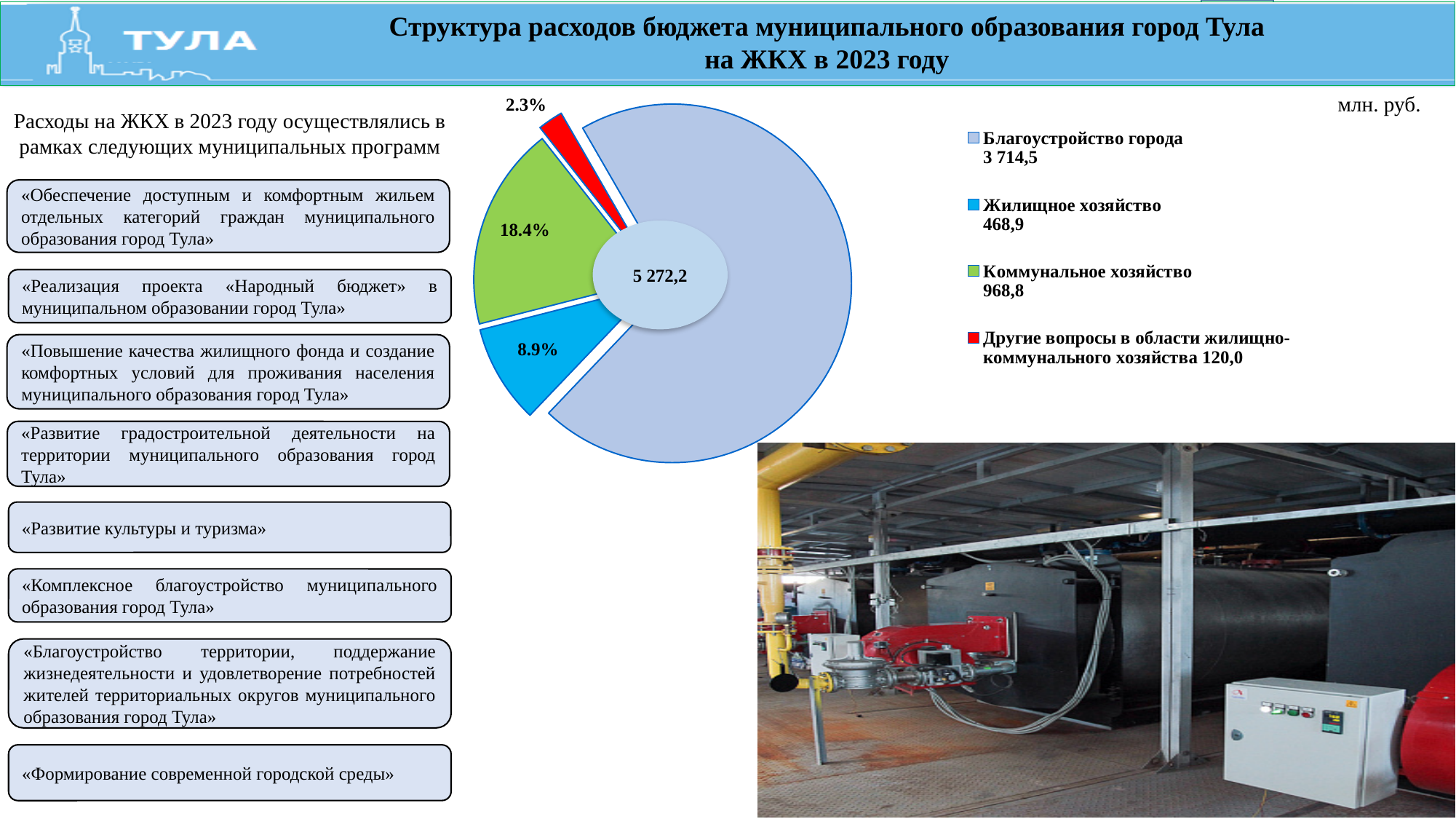
What total value is printed in the centre of the pie chart? 5 272,2 What kind of chart is shown on the slide? pie chart How many categories does the pie chart legend list? 4 What value is shown for Другие вопросы в области жилищно-коммунального хозяйства? 120,0 Which category has the smallest slice of the pie chart? Другие вопросы в области жилищно-коммунального хозяйства What percentage label is shown on the Коммунальное хозяйство slice? 18.4% What value is shown for Благоустройство города in the legend? 3 714,5 What value is shown for Коммунальное хозяйство in the legend? 968,8 What percentage label is shown on the Жилищное хозяйство slice? 8.9% What value is shown for Жилищное хозяйство in the legend? 468,9 Which category has the largest slice of the pie chart? Благоустройство города What percentage label is shown on the Другие вопросы в области жилищно-коммунального хозяйства slice? 2.3%